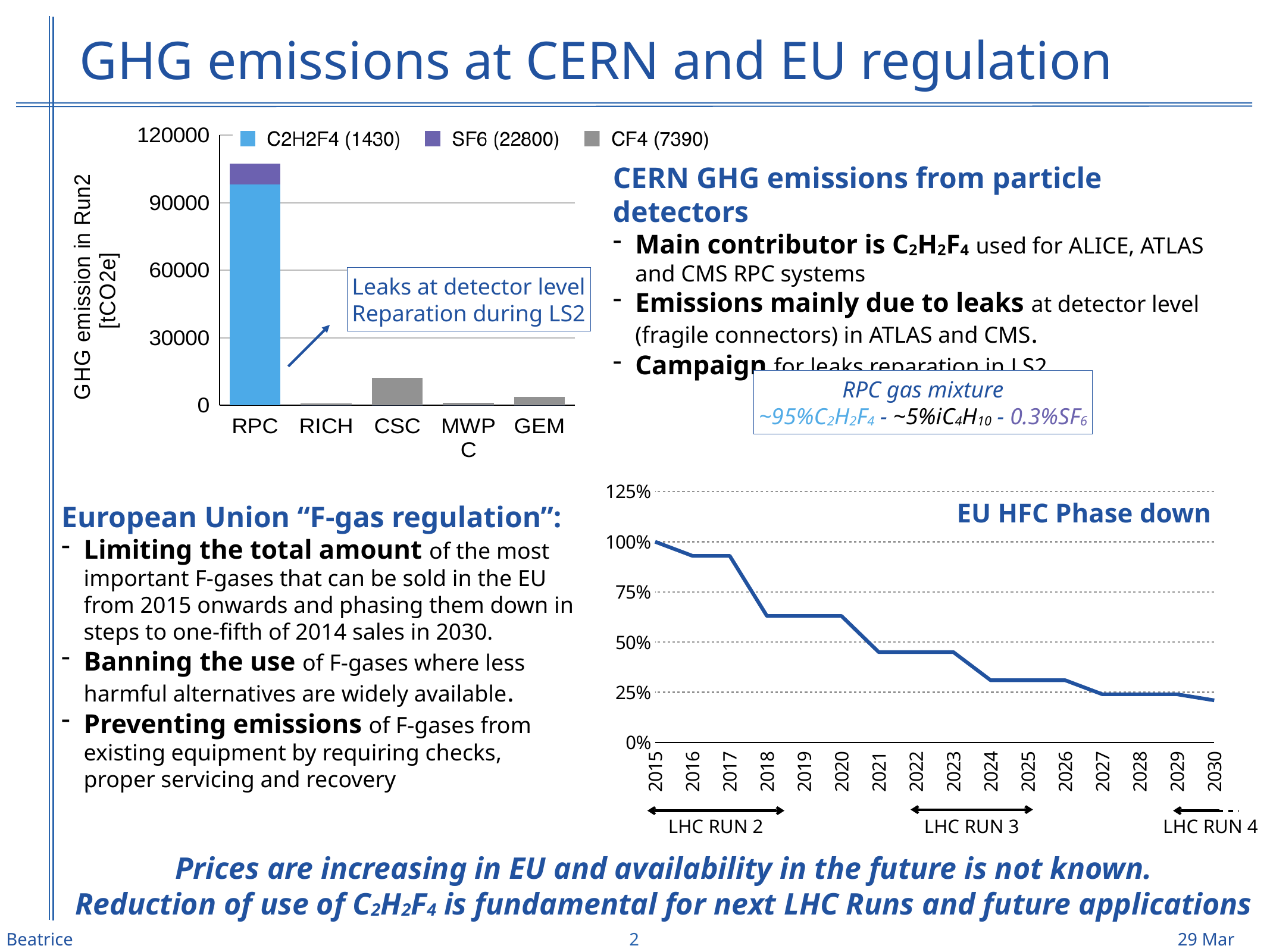
In the GHG emission in Run2 bar chart, which has the larger emission, CSC or GEM? CSC In the EU HFC Phase down chart, do the values rise or fall from 2015 to 2030? fall In the GHG emission in Run2 bar chart, how many series does the legend list? 3 In the EU HFC Phase down chart, is the value for 2018 greater or less than 50%? greater In the GHG emission in Run2 bar chart, how many detector categories are shown on the x axis? 5 In the GHG emission in Run2 bar chart, is the value for CSC greater or less than 30000? less In the GHG emission in Run2 bar chart, which gas does the legend associate with the grey colour? CF4 (7390) In the GHG emission in Run2 bar chart, is the total value for RPC greater or less than 90000? greater In the EU HFC Phase down chart, what is the value for 2015? 100% In the GHG emission in Run2 bar chart, which detector category has the highest total emission? RPC What kind of chart is the EU HFC Phase down chart? line chart What kind of chart is the chart on the top left showing GHG emission in Run2? bar chart